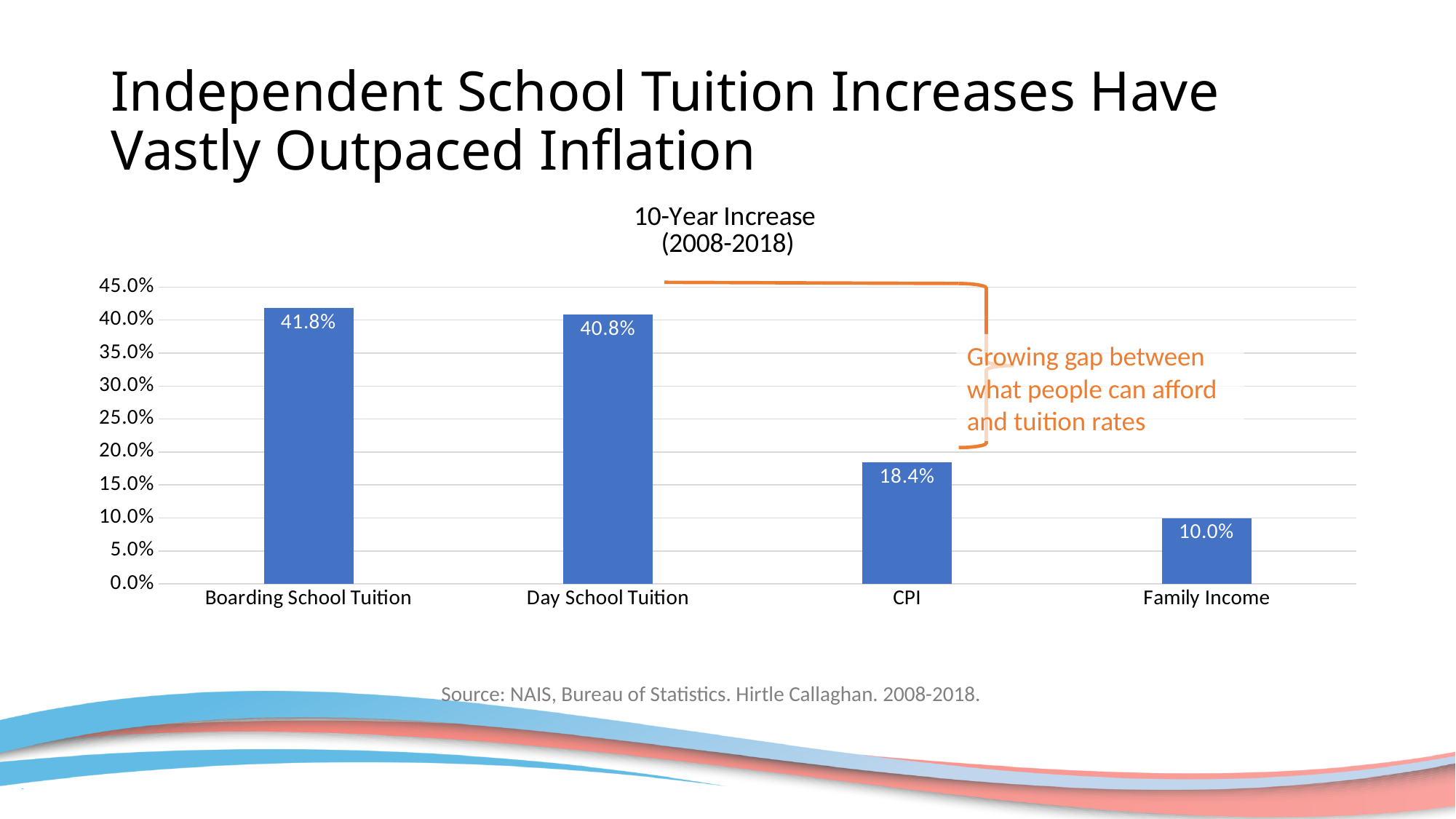
What kind of chart is shown on the slide? Bar chart What is the title of the chart? 10-Year Increase (2008-2018) Which is larger, the increase for CPI or for Family Income? CPI Which category has the highest 10-year increase? Boarding School Tuition What is the 10-year increase for CPI? 18.4% What is the 10-year increase for Boarding School Tuition? 41.8% What is the difference between the Boarding School Tuition increase and the CPI increase? 23.4% What is the difference between the Day School Tuition increase and the Family Income increase? 30.8% What is the 10-year increase for Day School Tuition? 40.8% Which category has the lowest 10-year increase? Family Income How many categories are shown in the chart? 4 What is the 10-year increase for Family Income? 10.0%